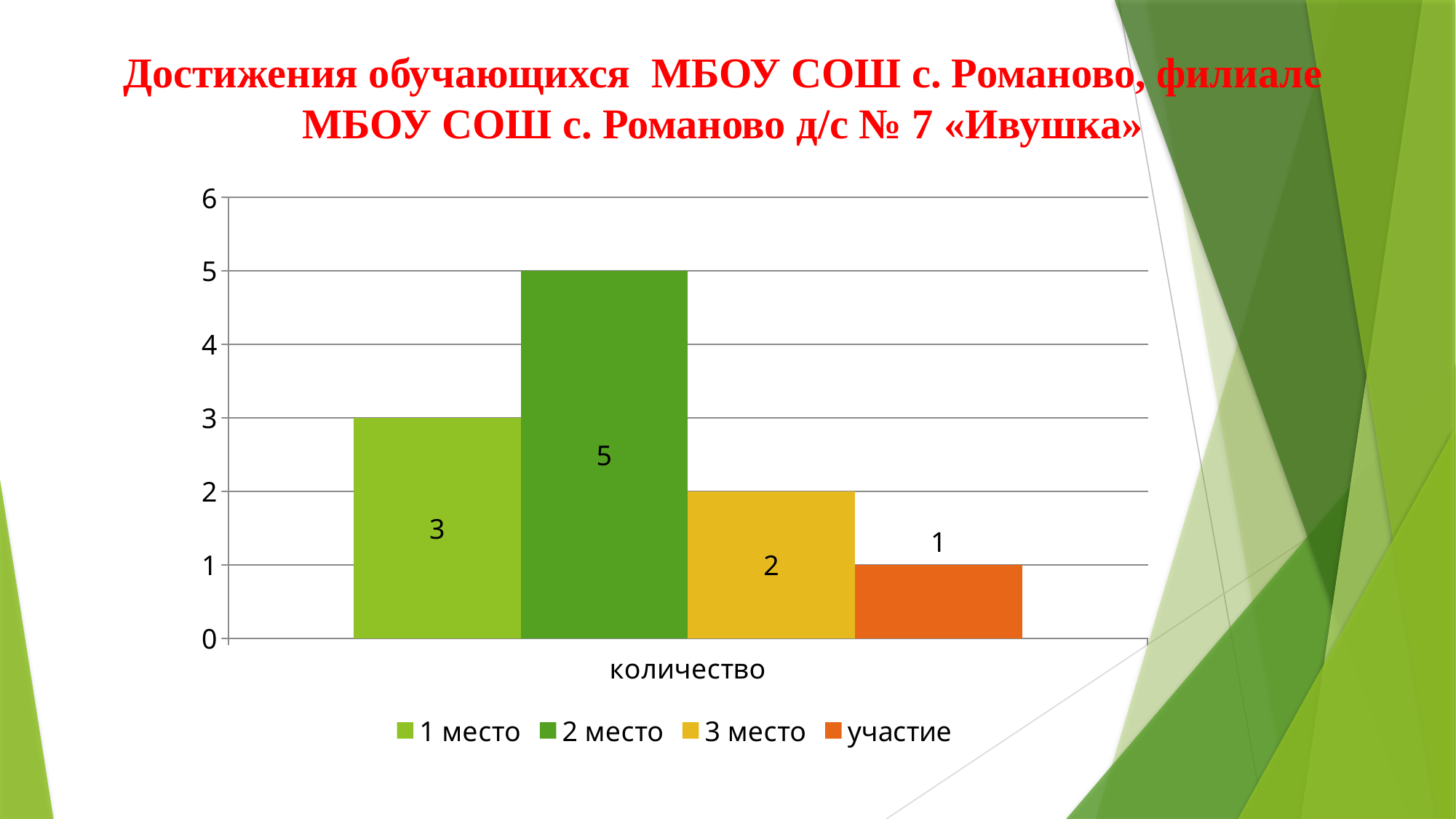
Which series has the highest value? 2 место What is the value for "3 место"? 2 Which series has the lowest value? участие What is the label on the x axis of the chart? количество What is the difference between the values for "2 место" and "1 место"? 2 How many series does the legend list? 4 Is the value for "2 место" greater or less than 4? greater What is the value for "1 место"? 3 What kind of chart is shown on the slide? bar chart What is the value for "участие"? 1 Which is larger, the value for "3 место" or the value for "участие"? 3 место What is the value for "2 место"? 5